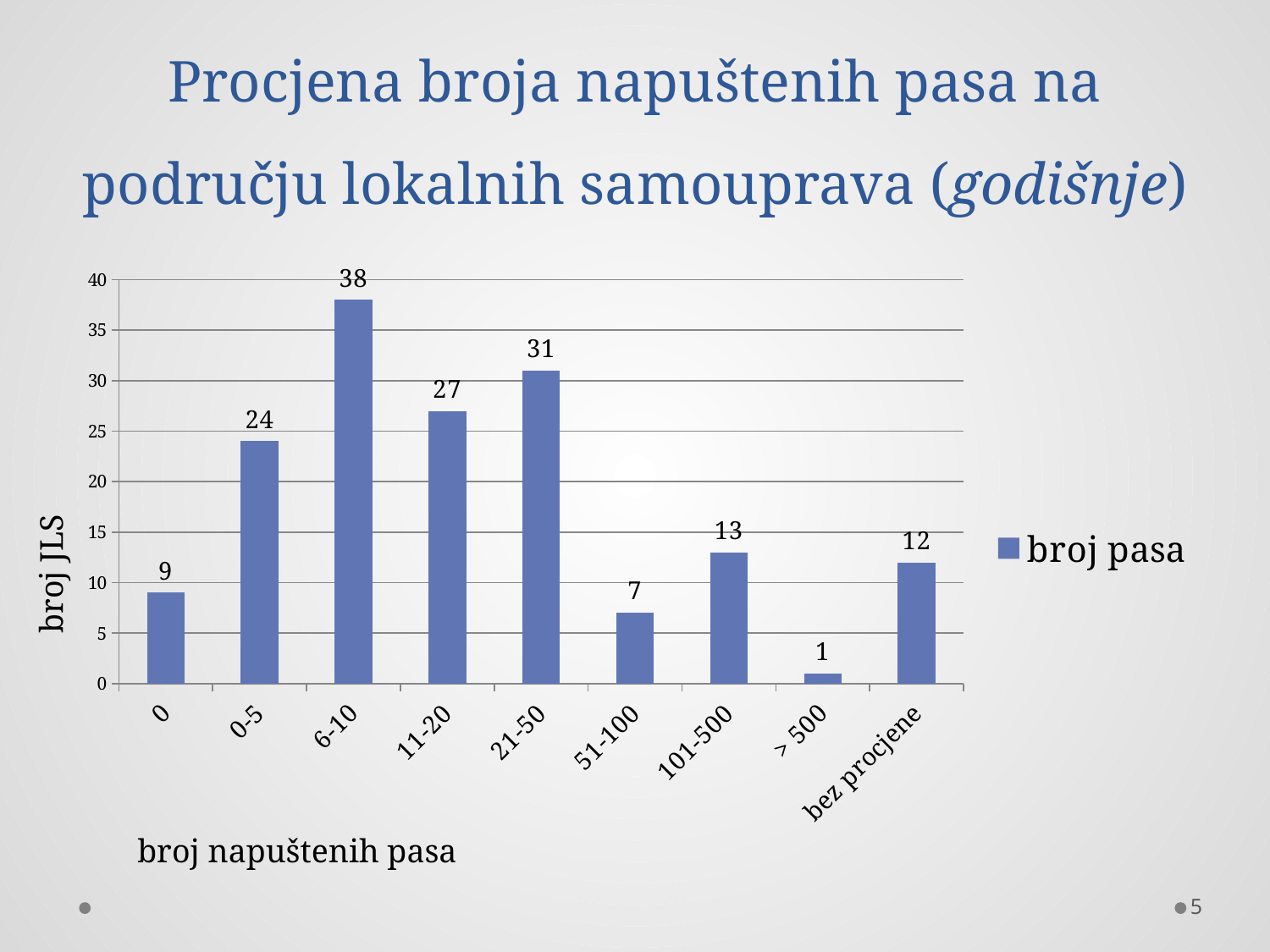
What is the label of the y axis? broj JLS What is the difference between the values for '6-10' and '21-50'? 7 What kind of chart is shown on the slide? bar chart Which is larger, the value for '0-5' or the value for '11-20'? 11-20 Which category has the lowest value? > 500 What is the value for the 'bez procjene' category? 12 How many categories are shown on the x axis? 9 How many series does the legend list? 1 What is the value for the '6-10' category? 38 Is the value for '101-500' greater or less than 10? greater What is the value for the '51-100' category? 7 Which category has the highest value? 6-10